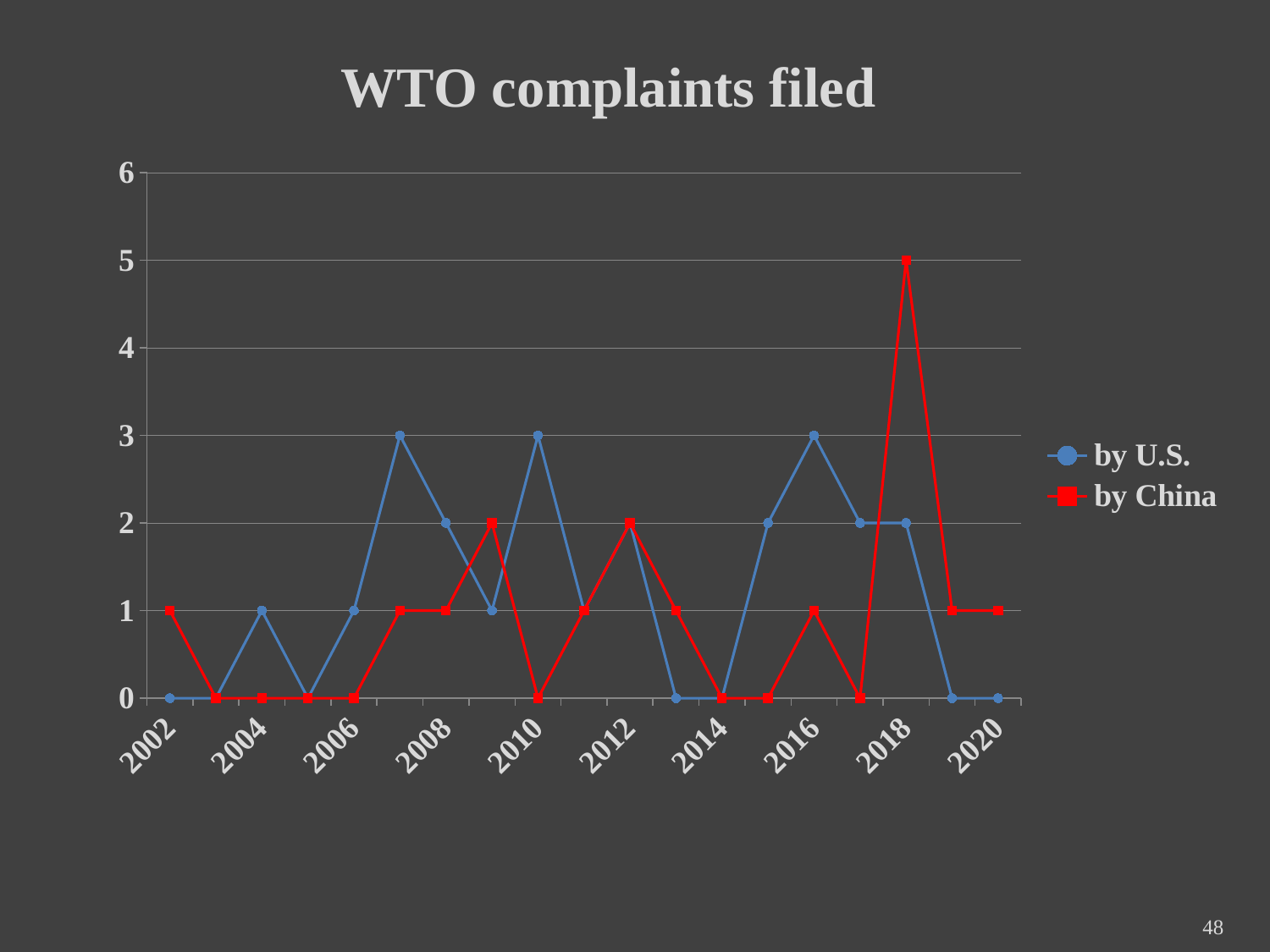
How many WTO complaints were filed by the U.S. in 2020? 0 What is the difference between the complaints filed by China and by the U.S. in 2018? 3 How many WTO complaints were filed by the U.S. in 2016? 3 In which year did China file the most WTO complaints? 2018 What kind of chart is shown on the slide? line chart In 2016, which series has the higher value, by U.S. or by China? by U.S. How many WTO complaints were filed by the U.S. in 2010? 3 How many WTO complaints were filed by China in 2012? 2 What is the title of the chart? WTO complaints filed How many WTO complaints were filed by China in 2018? 5 In 2018, which series has the higher value, by U.S. or by China? by China How many series does the legend list? 2